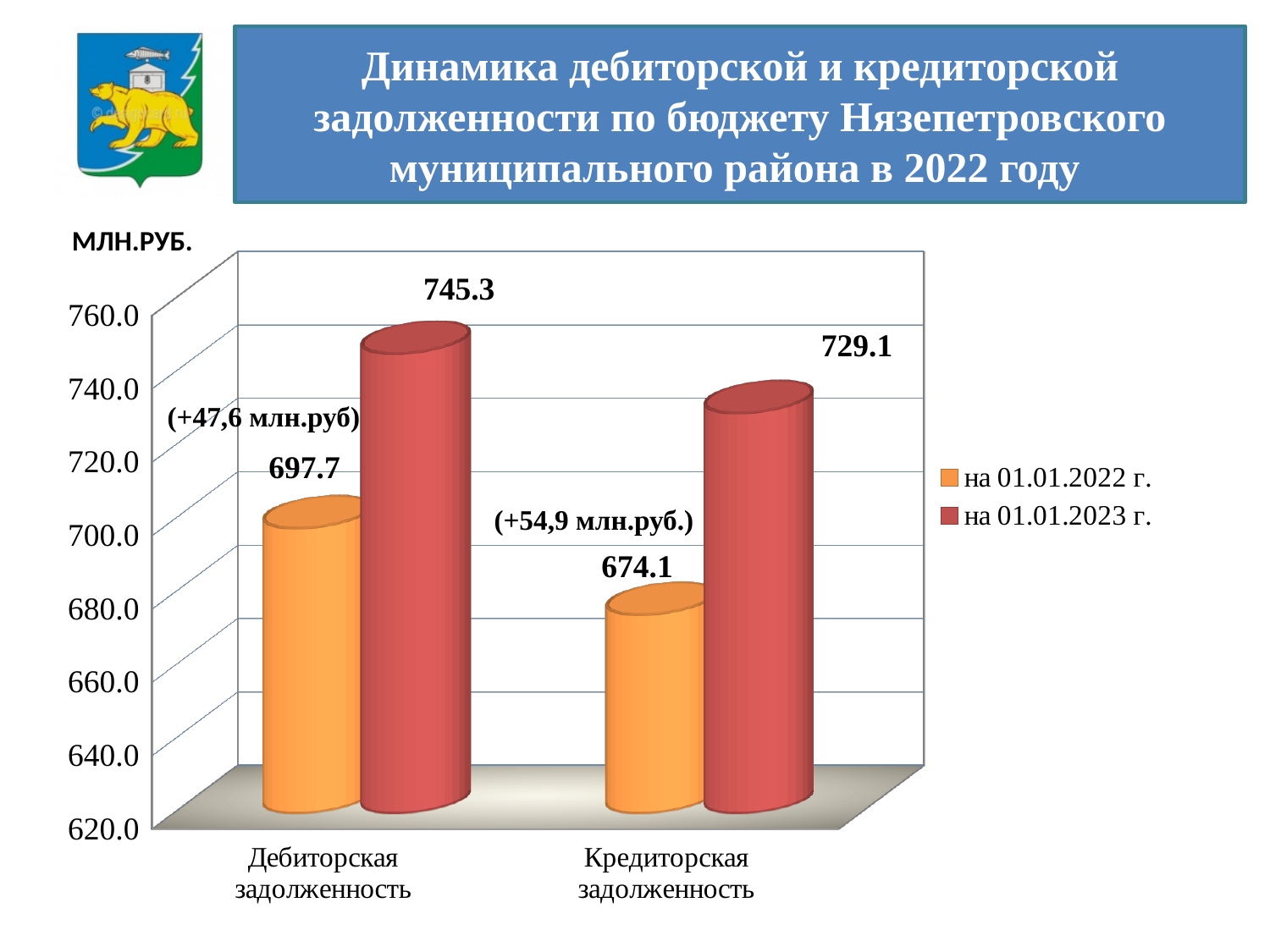
Which bar has the highest value on the chart? Дебиторская задолженность на 01.01.2023 г. Which bar has the lowest value on the chart? Кредиторская задолженность на 01.01.2022 г. Which is larger: Дебиторская задолженность on 01.01.2023 г. or Кредиторская задолженность on 01.01.2023 г.? Дебиторская задолженность Is the value for Кредиторская задолженность on 01.01.2022 г. greater or less than 680.0? less What is the value for Кредиторская задолженность on 01.01.2022 г.? 674.1 What is the value for Дебиторская задолженность on 01.01.2023 г.? 745.3 What kind of chart is shown on the slide? bar chart What is the value for Дебиторская задолженность on 01.01.2022 г.? 697.7 What is the difference between the 01.01.2023 г. and 01.01.2022 г. values for Дебиторская задолженность? 47.6 How many categories are shown on the x axis? 2 What is the value for Кредиторская задолженность on 01.01.2023 г.? 729.1 How many series does the legend list? 2